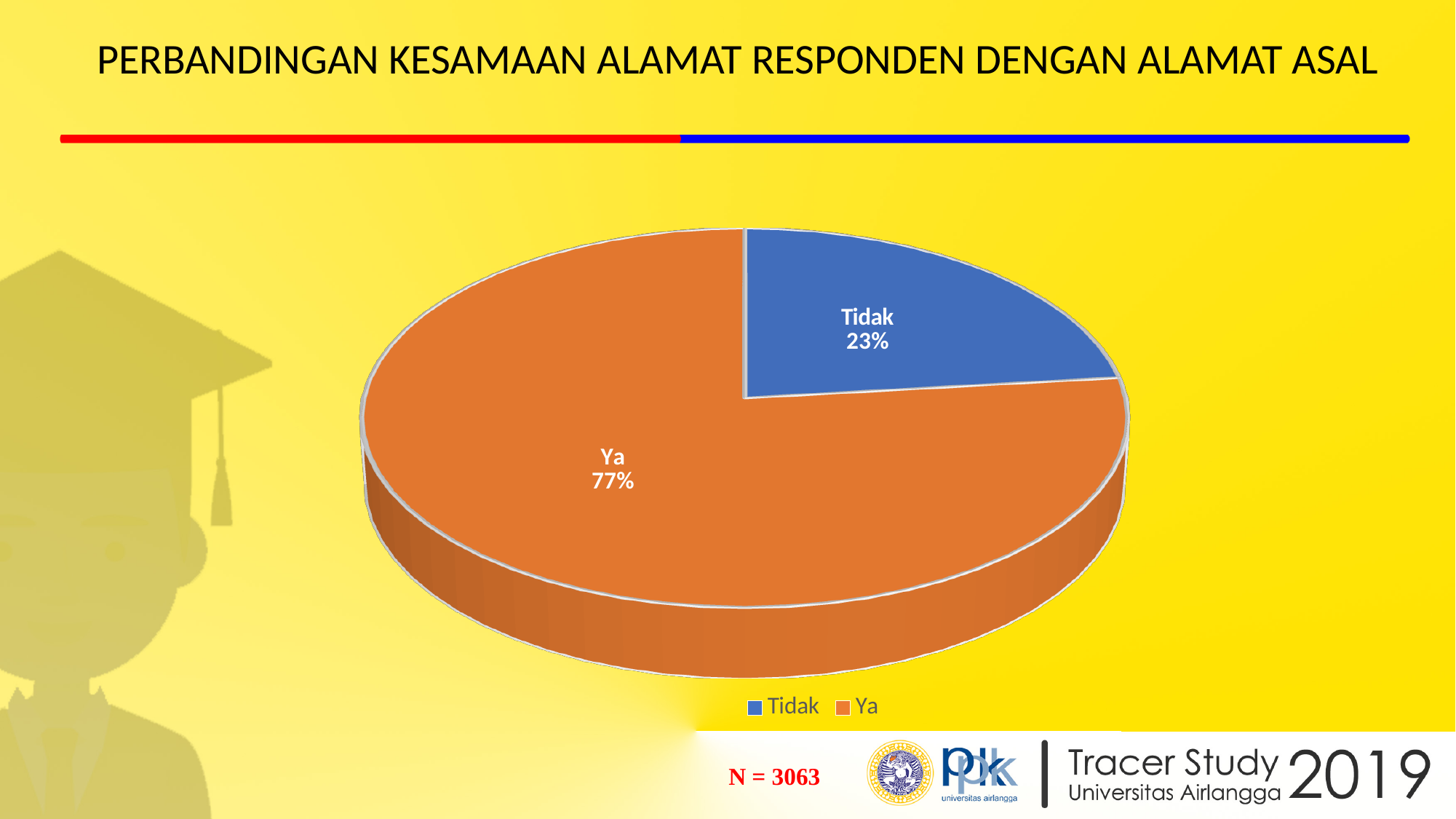
What percentage of respondents answered "Tidak"? 23% Which category has the smallest share of the pie? Tidak How many slices does the pie chart have? 2 What kind of chart is shown on the slide? pie chart What percentage of respondents answered "Ya"? 77% What colour is the "Ya" slice? orange Which is larger, the share for "Ya" or the share for "Tidak"? Ya Which category has the largest share of the pie? Ya How many entries does the legend list? 2 What is the share of the pie taken by the "Tidak" slice? 23% What is the difference in percentage points between the "Ya" and "Tidak" slices? 54 What is the value of N shown on the slide? 3063